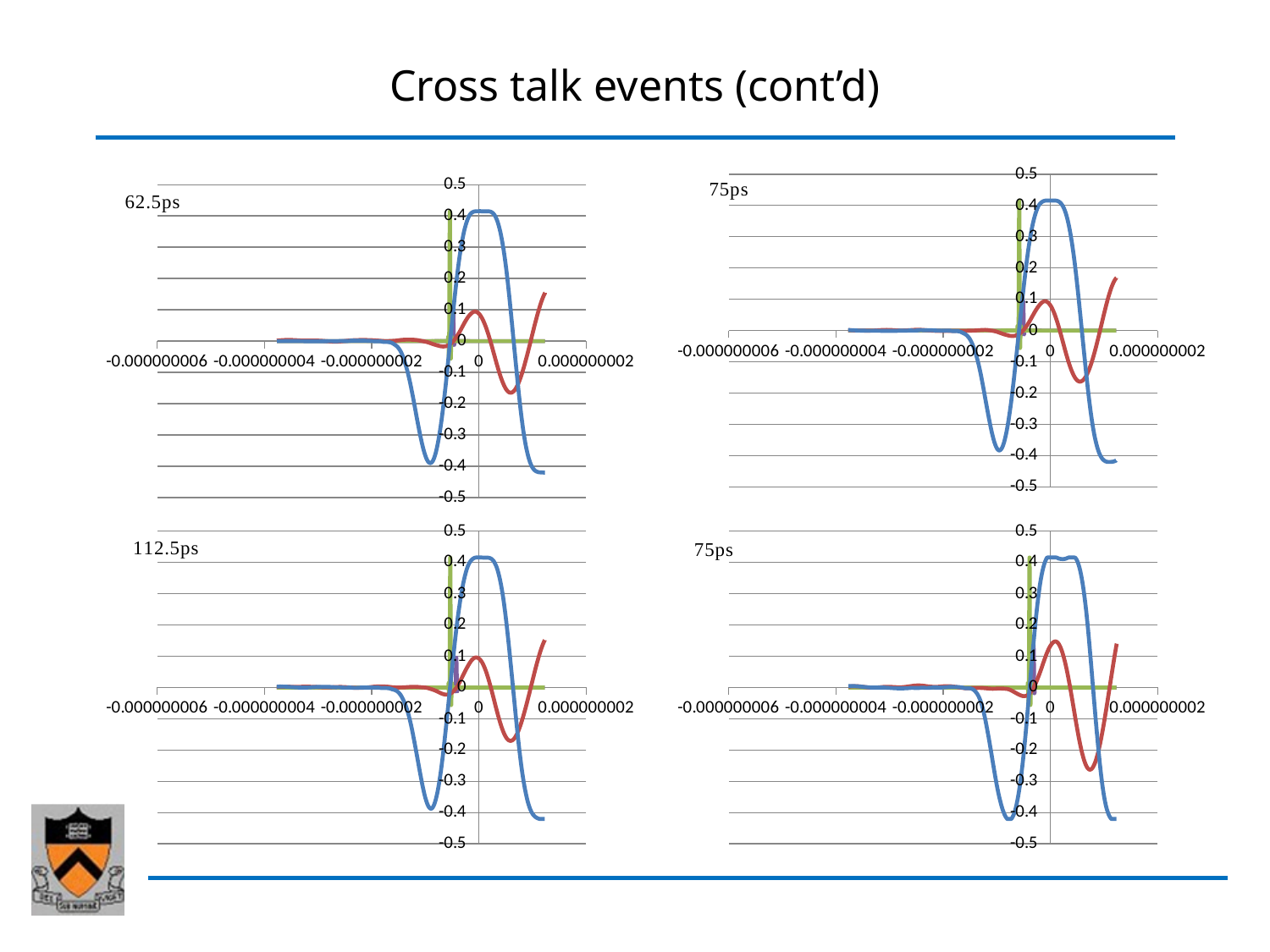
In the top-left chart labelled 62.5ps, is the peak of the blue line greater or less than 0.3? greater In the top-right chart labelled 75ps, is the value of the blue line at x = 0 greater or less than 0.2? greater In the bottom-right chart labelled 75ps, which line reaches a lower minimum, the blue line or the red line? blue line How many charts are shown on the slide? 4 What kind of chart is the top-left chart labelled 62.5ps? line chart In the bottom-left chart labelled 112.5ps, which line reaches a higher peak, the blue line or the red line? blue line In the bottom-right chart labelled 75ps, is the lowest point of the red line greater or less than -0.2? less What is the leftmost tick label on the horizontal axis of the bottom-left chart labelled 112.5ps? -0.000000006 What is the label of the bottom-left chart? 112.5ps What is the highest value shown on the vertical axis of the top-left chart labelled 62.5ps? 0.5